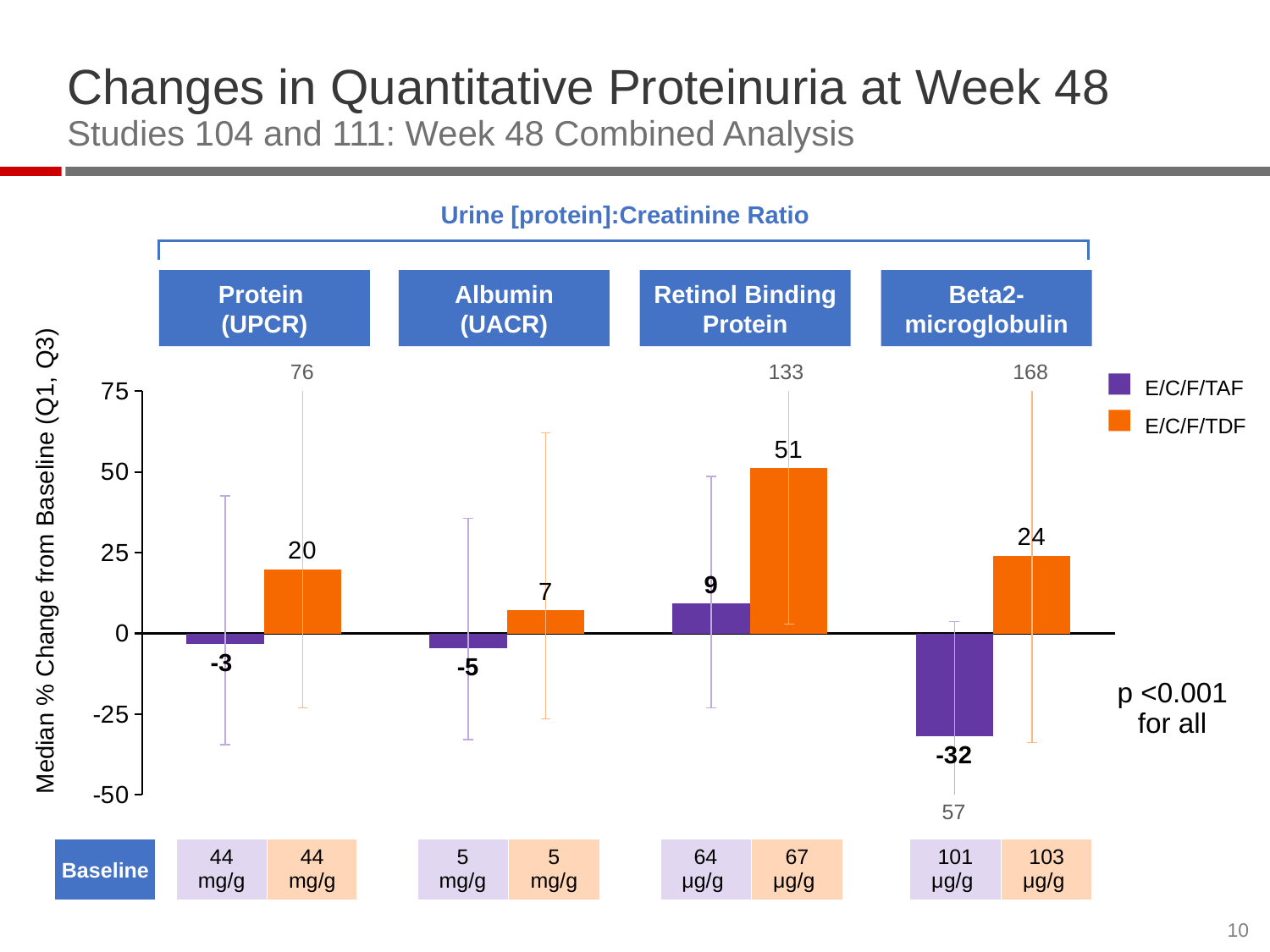
How many series does the chart legend list? 2 Which category has the lowest median % change from baseline for E/C/F/TAF? Beta2-microglobulin What is the median % change from baseline for E/C/F/TDF in the Albumin (UACR) category? 7 What is the baseline value shown for E/C/F/TDF in the Retinol Binding Protein category? 67 µg/g What is the difference between the E/C/F/TDF and E/C/F/TAF median % change values in the Retinol Binding Protein category? 42 In the Albumin (UACR) category, which series has the larger median % change from baseline, E/C/F/TAF or E/C/F/TDF? E/C/F/TDF What is the median % change from baseline for E/C/F/TAF in the Retinol Binding Protein category? 9 What is the median % change from baseline for E/C/F/TAF in the Beta2-microglobulin category? -32 How many categories are shown on the x axis of the chart? 4 Which category has the highest median % change from baseline for E/C/F/TDF? Retinol Binding Protein What kind of chart is shown on the slide? Bar chart What is the median % change from baseline for E/C/F/TDF in the Protein (UPCR) category? 20